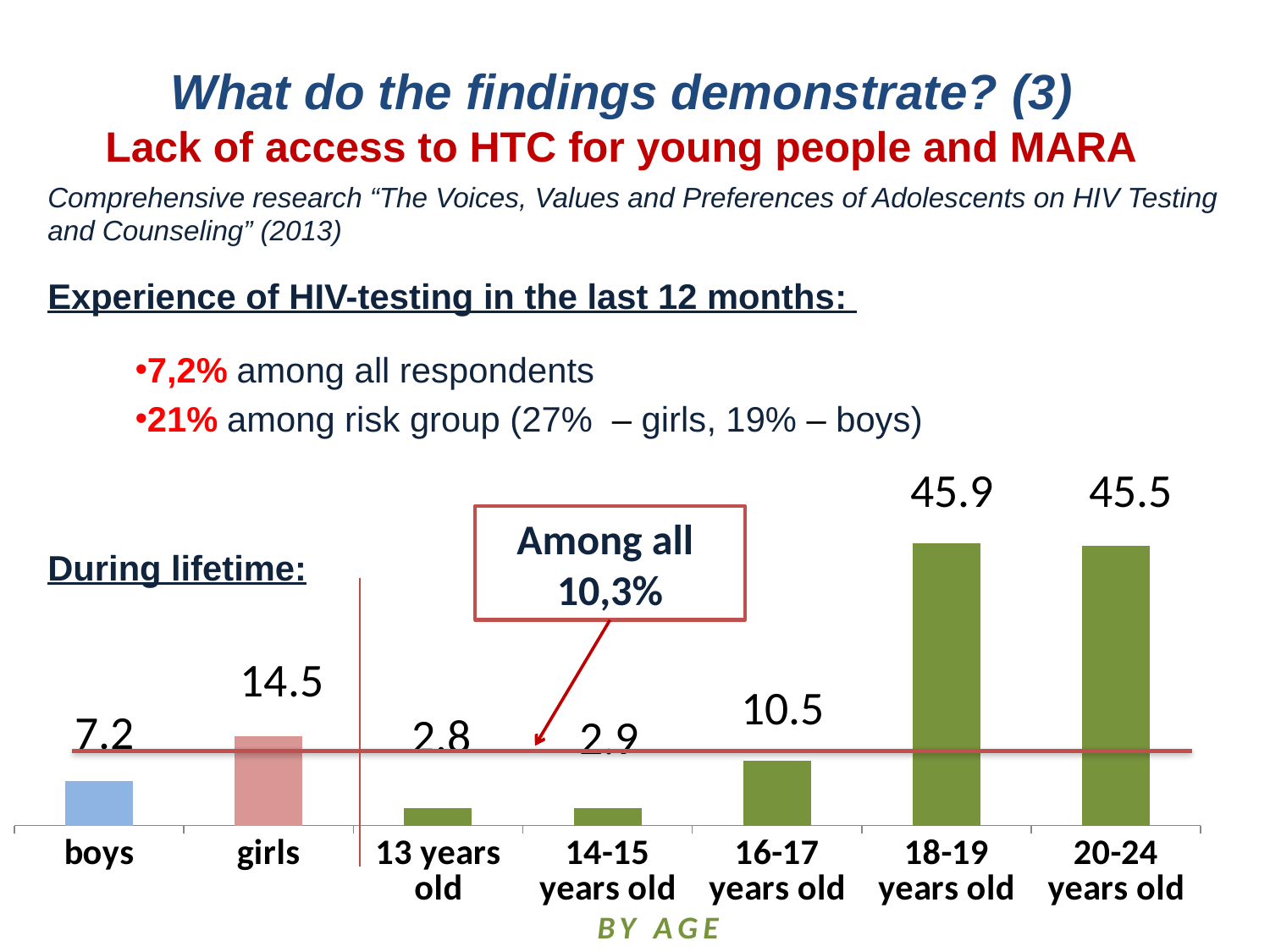
What is the value for girls in the bar chart? 14.5 What is the value for the 16-17 years old group? 10.5 What value does the red box labelled 'Among all' give for the horizontal line on the chart? 10,3% What is the difference between the values for the 18-19 years old and 20-24 years old groups? 0.4 What kind of chart is shown on the slide? Bar chart Which age group has the highest value in the bar chart? 18-19 years old Which category has the lowest value in the bar chart? 13 years old What is the difference between the values for girls and boys? 7.3 Which is larger, the value for the 16-17 years old group or the 14-15 years old group? 16-17 years old What is the value for the 13 years old group? 2.8 How many bars are shown in the chart? 7 What is the value for boys in the bar chart? 7.2